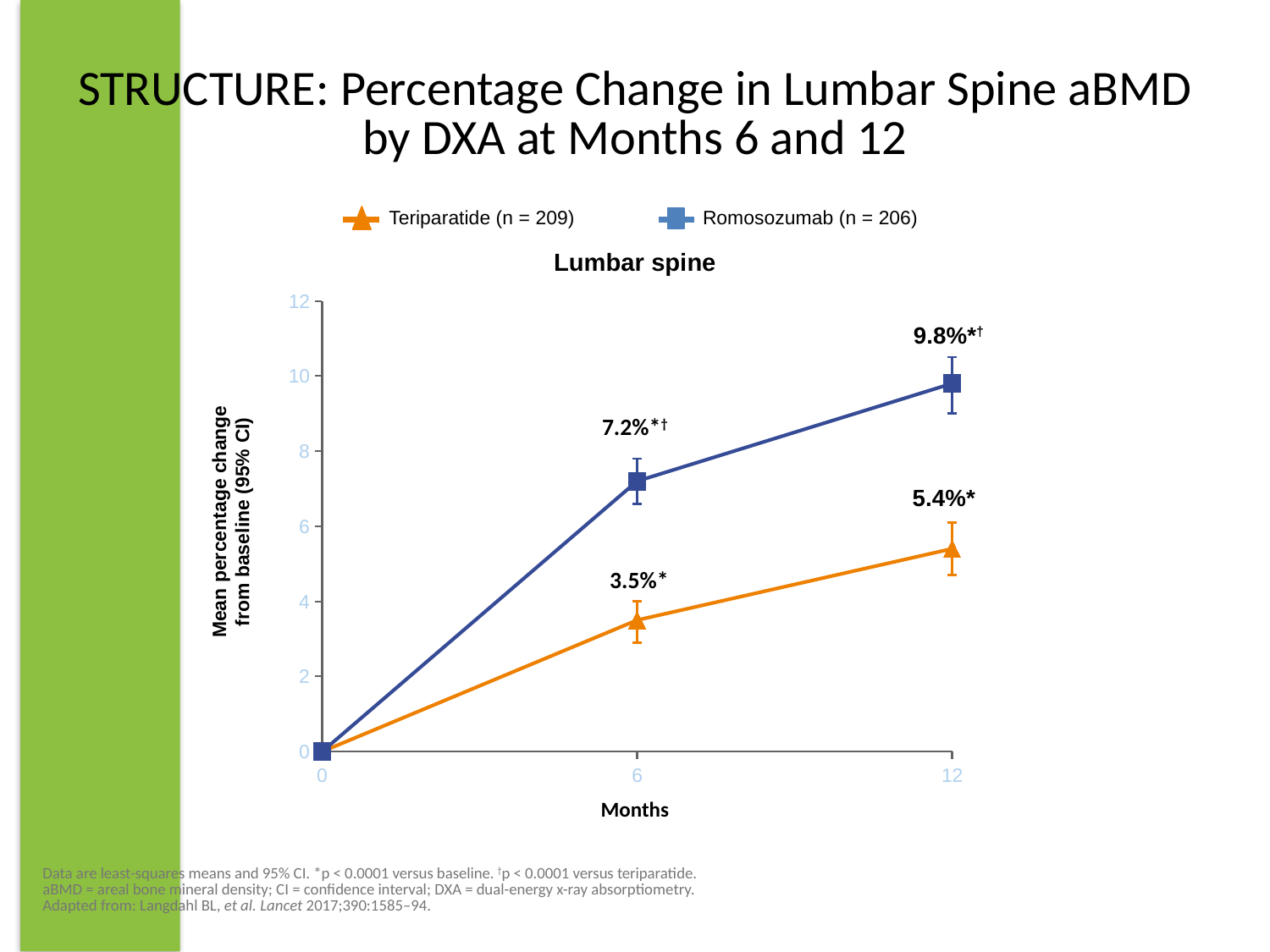
What is the mean percentage change from baseline for Romosozumab at month 6? 7.2% Do the values for Romosozumab rise or fall from month 0 to month 12? Rise How many time points are plotted on the x axis? 3 How many series does the legend list? 2 How many patients were in the Romosozumab group according to the legend? 206 What is the difference between the Romosozumab and Teriparatide values at month 6? 3.7% What is the mean percentage change from baseline in lumbar spine aBMD for Romosozumab at month 12? 9.8% What is the mean percentage change from baseline for Teriparatide at month 6? 3.5% What is the mean percentage change from baseline for Teriparatide at month 12? 5.4% Which treatment shows the higher percentage change in lumbar spine aBMD at month 12? Romosozumab What kind of chart is shown on the slide? Line chart What is the difference between the Romosozumab and Teriparatide values at month 12? 4.4%